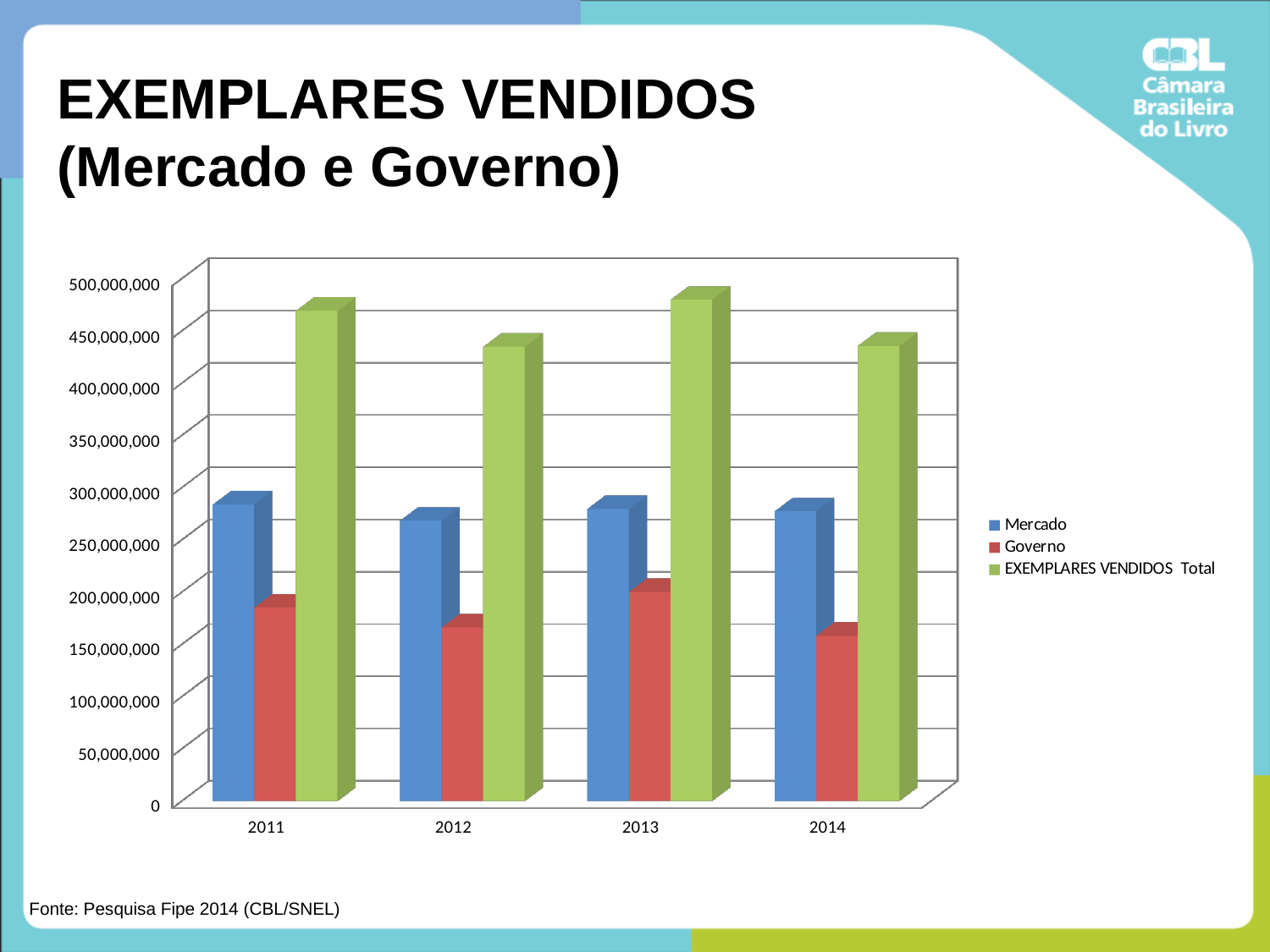
What kind of chart is shown on the slide? bar chart Is the Governo value for 2013 greater or less than 150,000,000? greater In which year is the Governo value highest? 2013 Is the EXEMPLARES VENDIDOS Total value for 2013 greater or less than 450,000,000? greater Which colour represents the Governo series in the legend? red In 2011, which is larger, Mercado or Governo? Mercado Is the Mercado value for 2011 greater or less than 250,000,000? greater How many series does the legend list? 3 How many years are shown on the x axis? 4 Which is larger, the Governo value for 2013 or for 2014? 2013